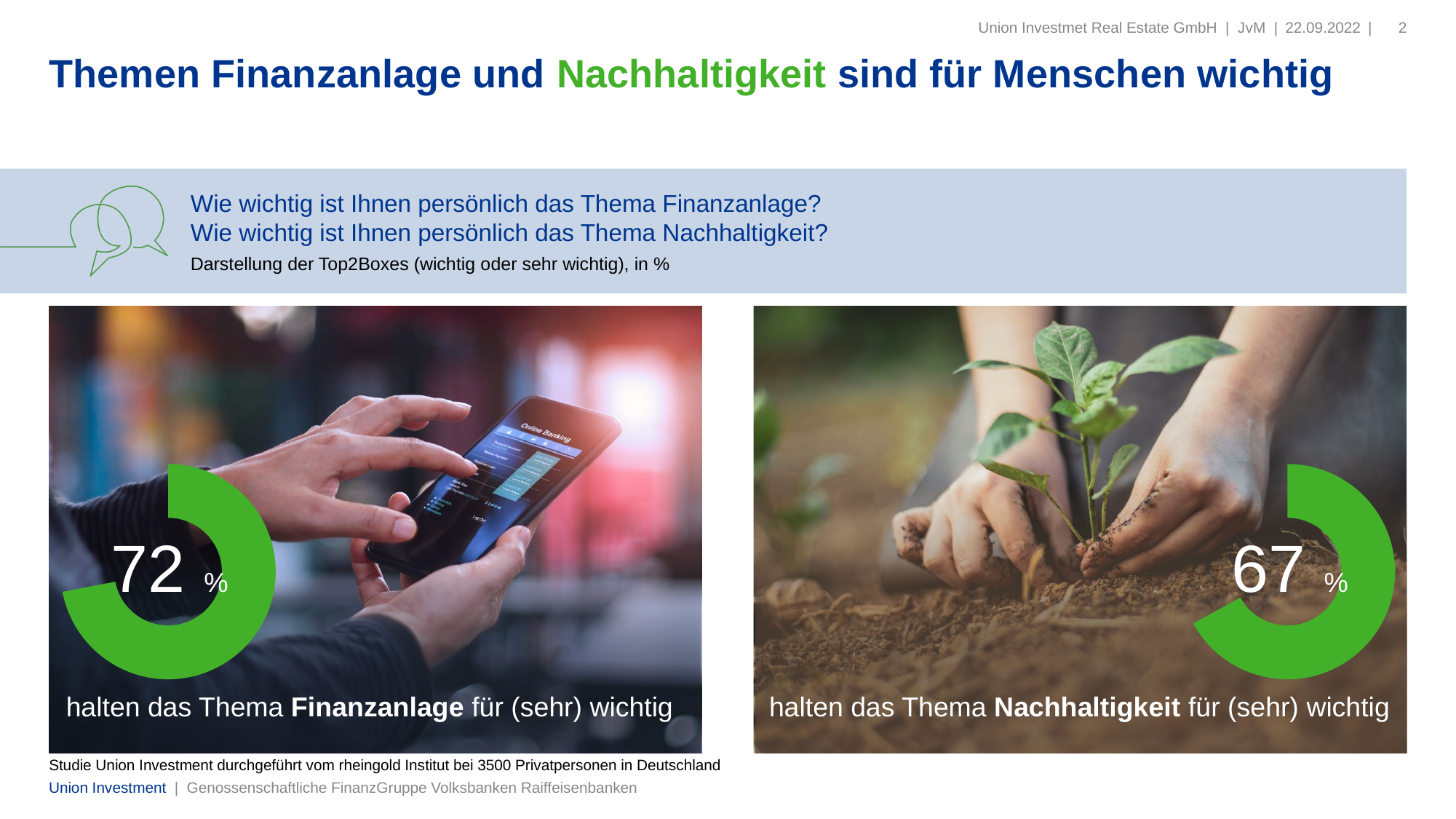
Which of the two topics shown has the lower Top2Box share? Nachhaltigkeit What percentage of respondents consider the topic Nachhaltigkeit (sehr) wichtig, according to the right chart? 67 % Which topic has the higher share of respondents rating it (sehr) wichtig, Finanzanlage or Nachhaltigkeit? Finanzanlage What kind of chart is used to display the 72 % value on the left? Donut chart What percentage of respondents consider the topic Finanzanlage (sehr) wichtig, according to the left chart? 72 % By how many percentage points does the Finanzanlage share exceed the Nachhaltigkeit share? 5 percentage points What colour is the filled portion of the donut charts? Green Is the value shown in the left chart for Finanzanlage greater or less than 75 %? less Is the value shown in the right chart for Nachhaltigkeit greater or less than 50 %? greater According to the subtitle, what do the percentages in the charts represent? Top2Boxes (wichtig oder sehr wichtig), in % How many donut charts are shown on the slide? 2